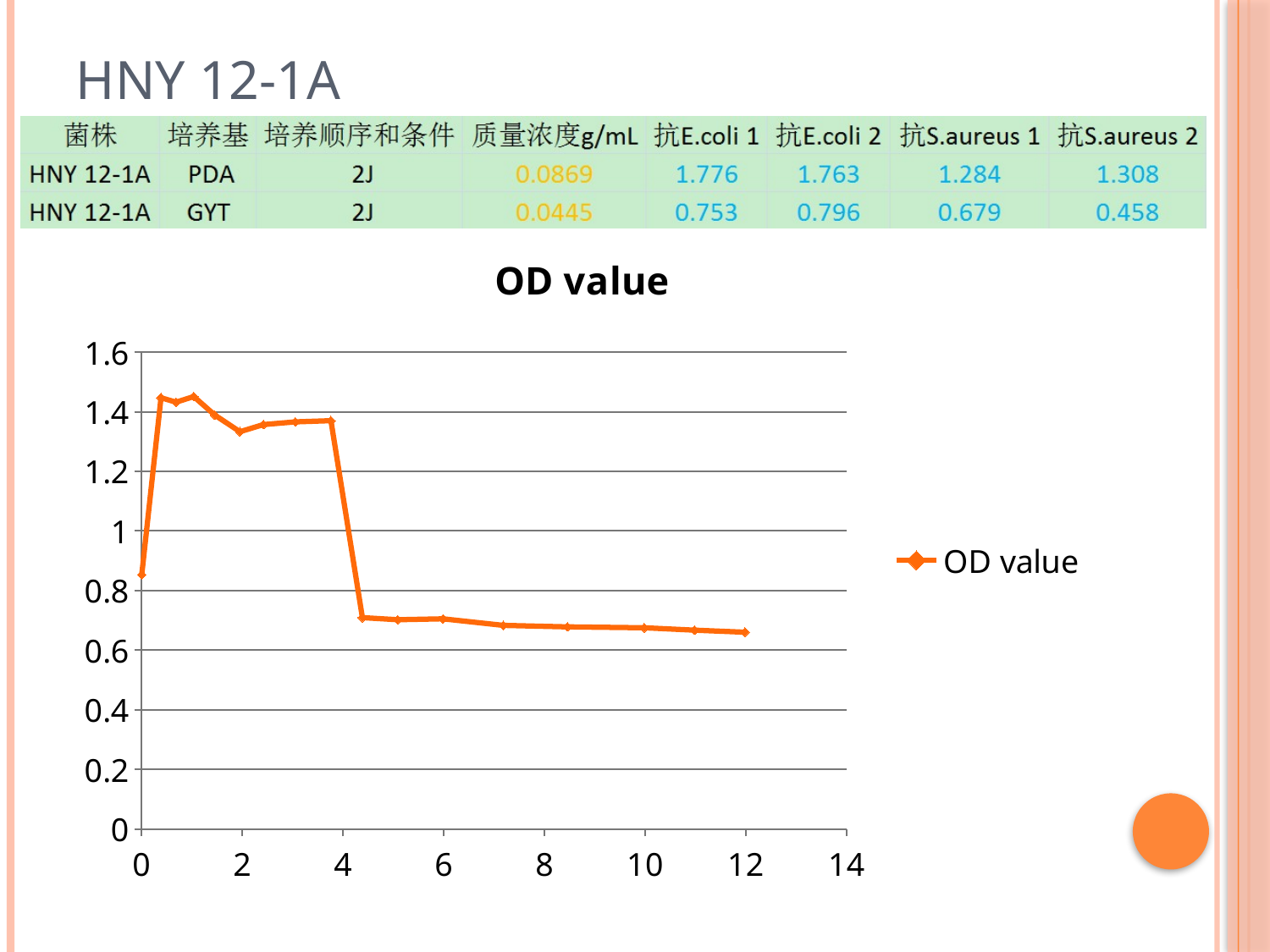
What kind of chart is shown on the slide? line chart How many series does the chart legend list? 1 What is the highest value shown on the y axis? 1.6 Is the OD value at x = 2 greater or less than 1.2? greater Is the OD value at x = 3 greater or less than 1.2? greater What is the title of the chart? OD value What is the name of the series shown in the legend? OD value Which is larger, the OD value at x = 2 or the OD value at x = 6? x = 2 Between x = 4 and x = 12, do the OD values generally rise or fall? fall Is the OD value at x = 6 greater or less than 0.8? less